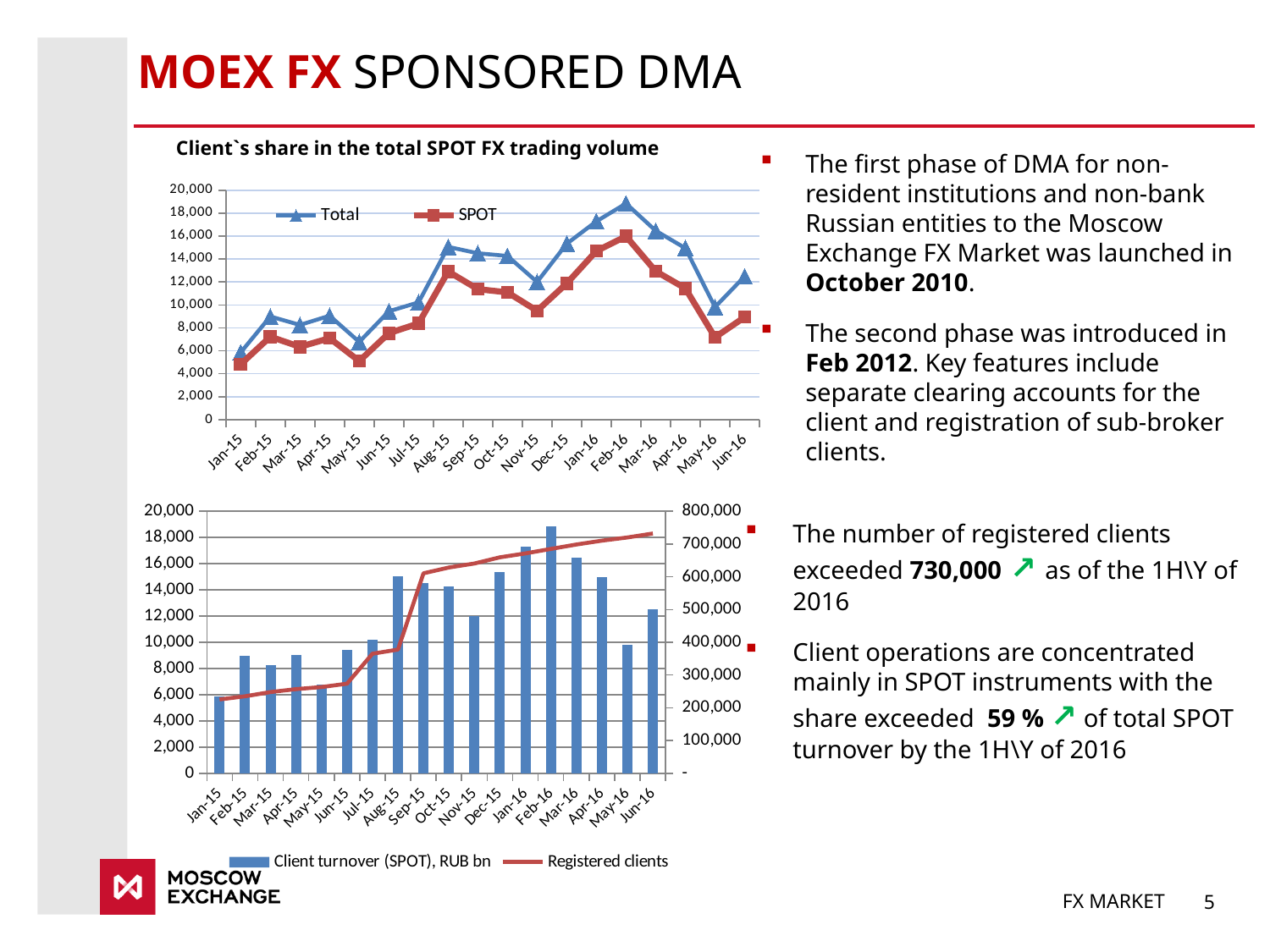
On the bottom chart, what kind of chart shows the Client turnover (SPOT), RUB bn series? bar chart On the top chart titled "Client`s share in the total SPOT FX trading volume", what kind of chart is it? line chart On the top chart, is the Total value for Feb-16 greater or less than 18,000? greater On the top chart, in which month does the Total series reach its highest value? Feb-16 On the top chart, which is larger in Aug-15, the Total value or the SPOT value? Total On the bottom chart, is the Registered clients value for Jun-16 greater or less than 700,000? greater On the bottom chart, does the Registered clients line generally rise or fall from Jan-15 to Jun-16? rise On the top chart, how many series does the legend list? 2 On the top chart, how many months are plotted along the x axis? 18 On the top chart, is the SPOT value for May-16 greater or less than 8,000? less On the bottom chart, in which month is the Client turnover (SPOT) bar the lowest? Jan-15 On the bottom chart, in which month is the Client turnover (SPOT) bar the highest? Feb-16